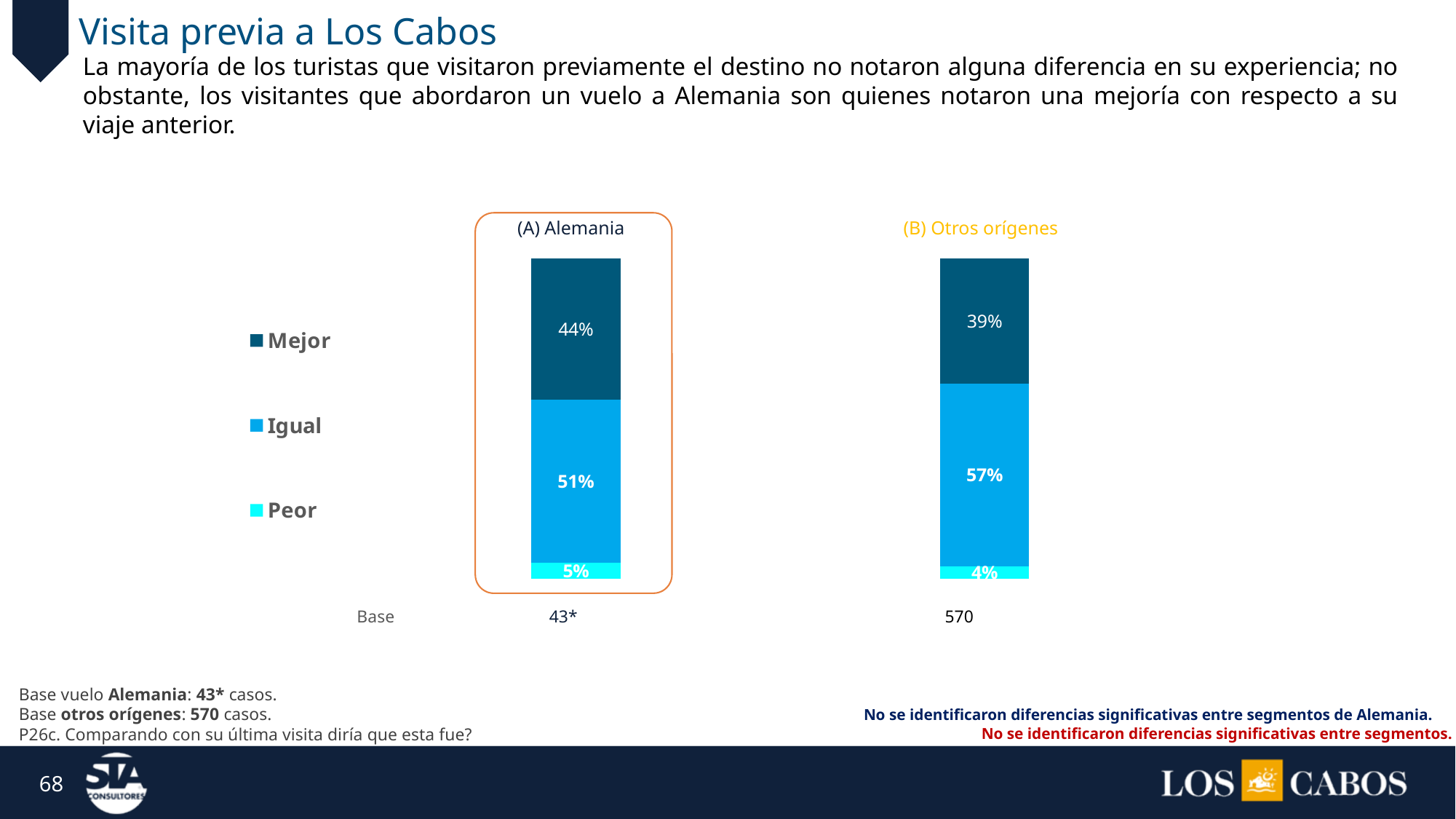
How many bars are shown in the chart? 2 What percentage of (B) Otros orígenes respondents said their visit was 'Igual'? 57% What percentage of (A) Alemania respondents said their visit was 'Mejor'? 44% Which group has a higher 'Mejor' share, (A) Alemania or (B) Otros orígenes? (A) Alemania Which response category is the largest for (B) Otros orígenes? Igual What is the base (number of cases) shown for (B) Otros orígenes? 570 What percentage of (A) Alemania respondents said their visit was 'Peor'? 5% What is the difference between the 'Igual' share for (B) Otros orígenes and for (A) Alemania? 6% How many series does the legend list? 3 What percentage of (B) Otros orígenes respondents said their visit was 'Mejor'? 39% Which response category is the smallest for (A) Alemania? Peor What kind of chart is shown on the slide? Stacked bar chart